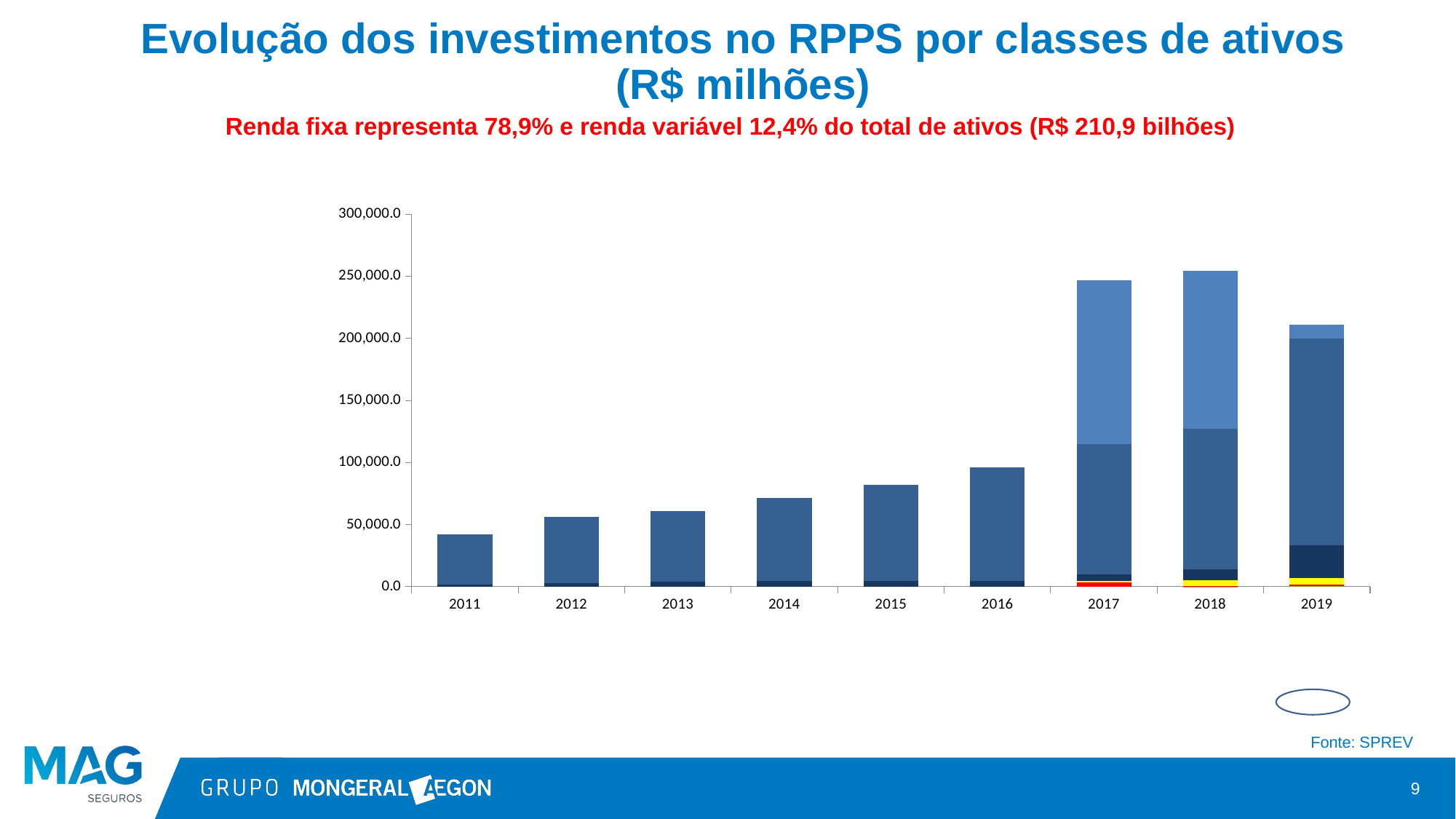
Which year has a taller stacked bar, 2017 or 2019? 2017 Which year has the tallest stacked bar in the chart? 2018 Which year has the shortest stacked bar in the chart? 2011 What is the title of the chart on the slide? Evolução dos investimentos no RPPS por classes de ativos (R$ milhões) Is the total bar value for 2011 greater or less than 50,000.0? less Do the total bar values rise or fall from 2011 to 2018? rise Is the total bar value for 2016 greater or less than 100,000.0? less What source is cited for the chart data? SPREV Is the total bar value for 2017 greater or less than 200,000.0? greater How many years are shown along the x axis of the chart? 9 What kind of chart is shown on the slide? Stacked bar chart